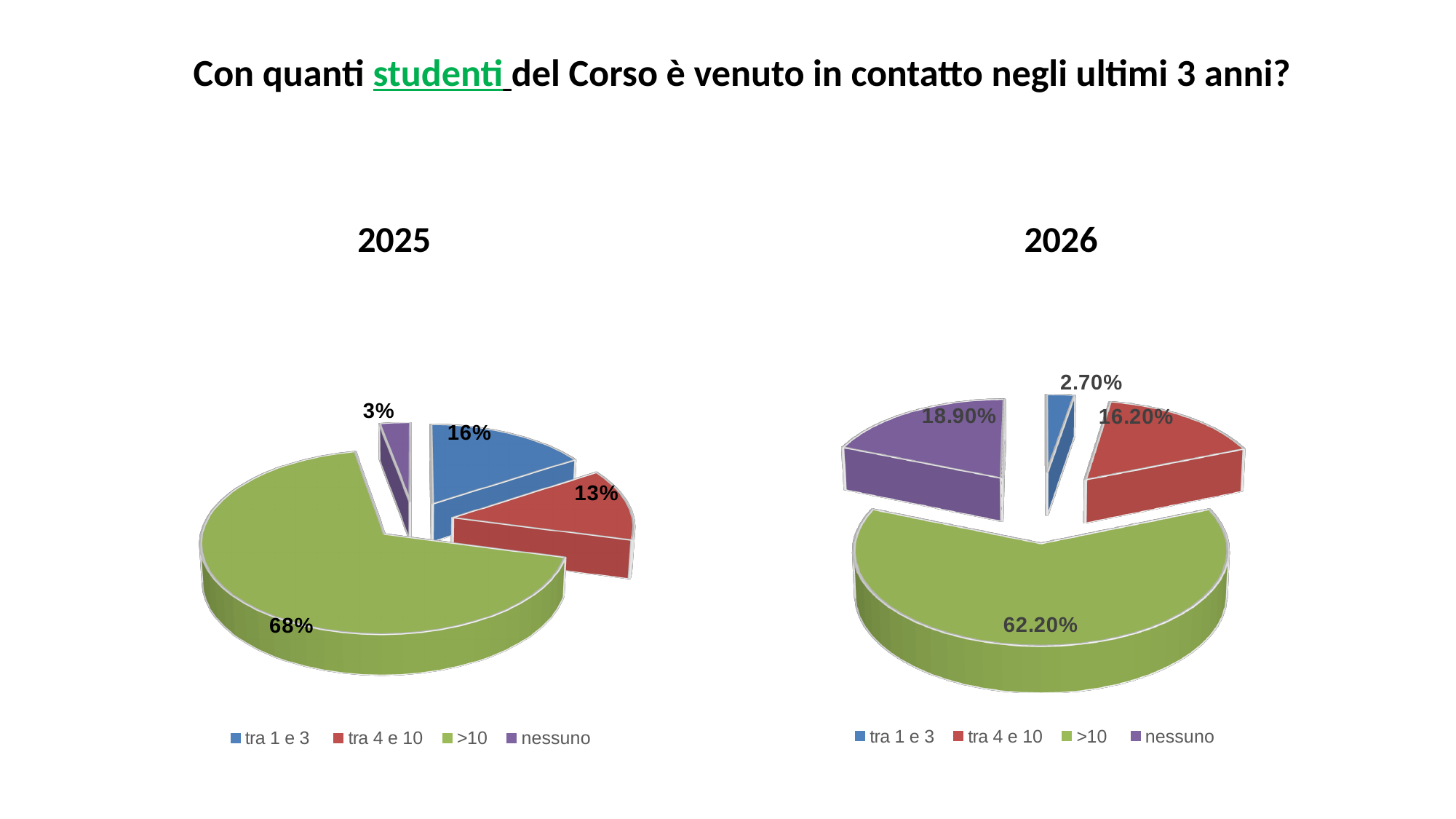
In the 2026 pie chart, what is the share for 'tra 4 e 10'? 16.20% What type of chart is used for the 2026 data? Pie chart In the 2025 pie chart, what is the share for '>10'? 68% In the 2025 pie chart, which category has the smallest share? nessuno In the 2026 pie chart, which category has the largest share? >10 In the 2026 pie chart, which category has the smallest share? tra 1 e 3 In the 2025 pie chart, what is the share for 'tra 1 e 3'? 16% In the 2026 pie chart, which is larger: the share for 'nessuno' or the share for 'tra 4 e 10'? nessuno In the 2026 pie chart, what is the share for 'nessuno'? 18.90% In the 2025 pie chart, which colour represents the '>10' category? Green In the 2025 pie chart, what is the difference between the shares for 'tra 1 e 3' and 'tra 4 e 10'? 3% How many categories does the legend of the 2025 pie chart list? 4